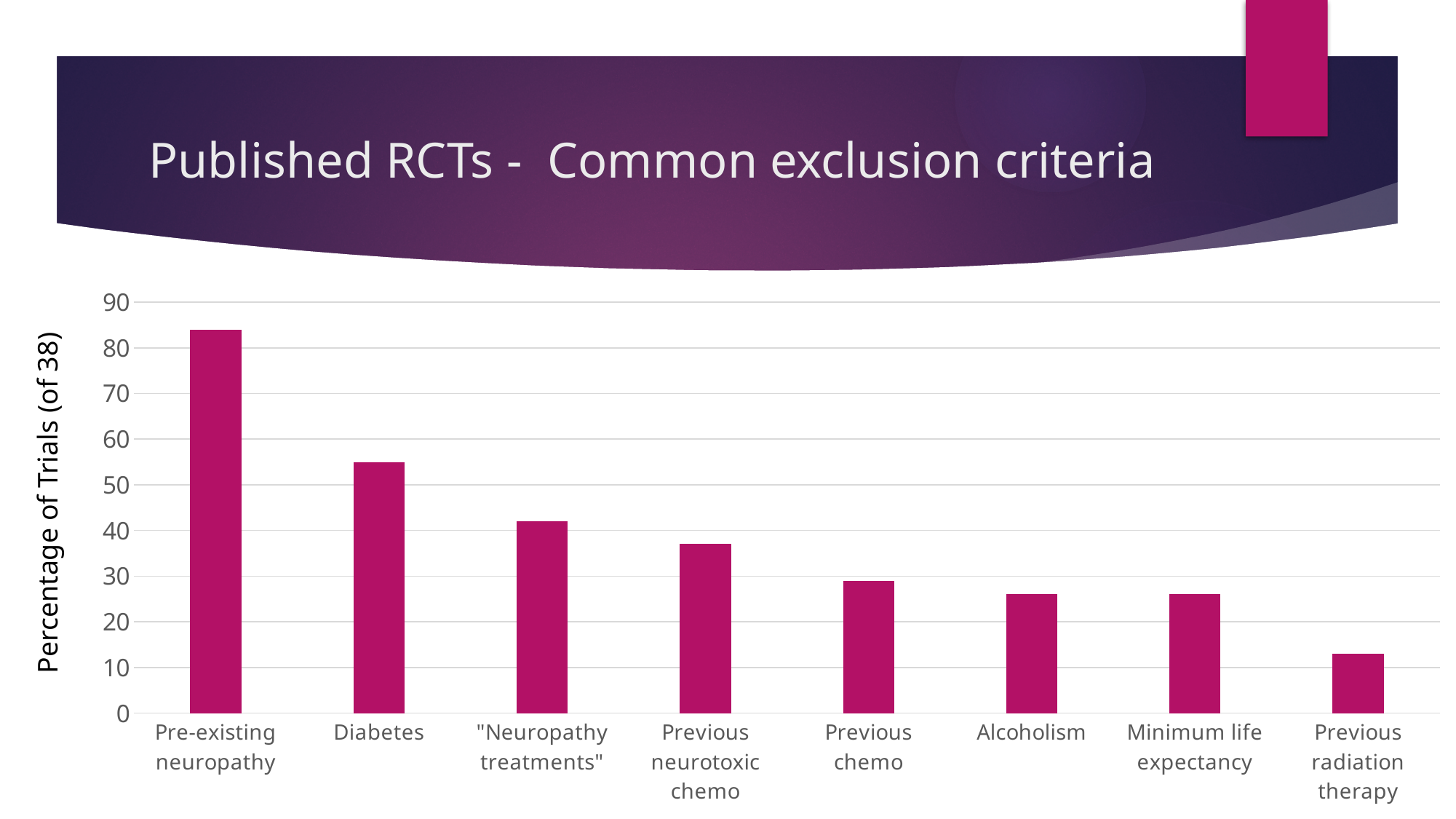
Is the value for Diabetes greater or less than 50? greater Is the value for Pre-existing neuropathy greater or less than 80? greater What is the label on the vertical axis of the chart? Percentage of Trials (of 38) How many exclusion criteria categories are plotted on the chart? 8 Which exclusion criterion has the highest percentage of trials? Pre-existing neuropathy Is the value for "Neuropathy treatments" greater or less than 50? less Which is larger, the value for Diabetes or the value for Previous neurotoxic chemo? Diabetes What kind of chart is shown on the slide? bar chart Which exclusion criterion has the lowest percentage of trials? Previous radiation therapy Do the bar values rise or fall moving from left to right along the x axis? fall